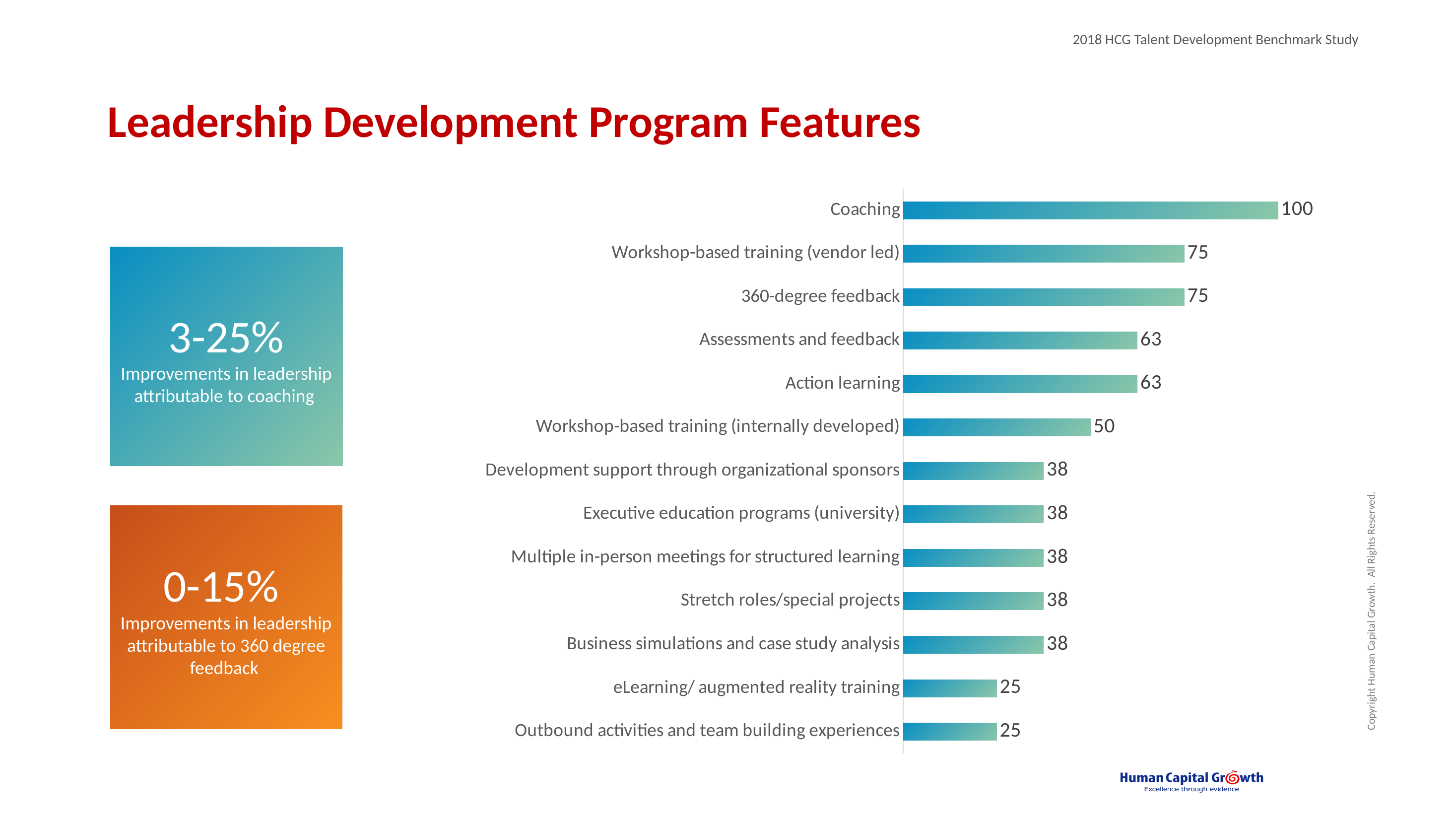
What is the value for Coaching? 100 What is the value for Workshop-based training (internally developed)? 50 What is the difference between the values for Coaching and 360-degree feedback? 25 What is the difference between the values for Assessments and feedback and Stretch roles/special projects? 25 What is the value for eLearning/ augmented reality training? 25 What is the value for Action learning? 63 Which category has the highest value? Coaching What kind of chart is shown on the slide? Bar chart Which is larger, the value for Workshop-based training (vendor led) or the value for Executive education programs (university)? Workshop-based training (vendor led) What is the value for Development support through organizational sponsors? 38 How many categories are shown in the chart? 13 How many categories have a value of 38? 5